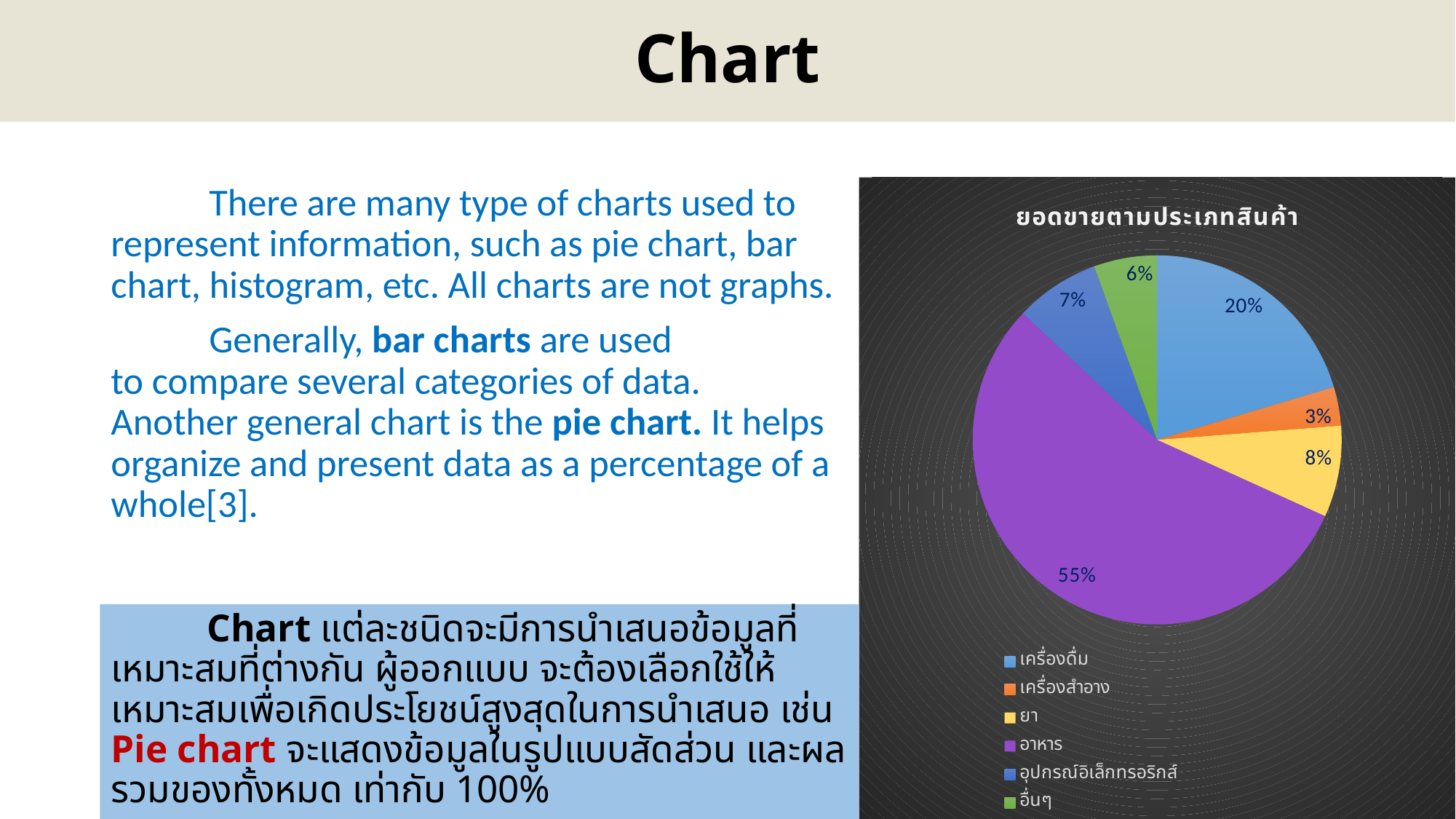
How many categories does the pie chart's legend list? 6 What share of the pie does ยา have? 8% Which category has the largest slice of the pie? อาหาร What kind of chart is shown on the slide? Pie chart What share of the pie does เครื่องสำอาง have? 3% Which has a larger share, อุปกรณ์อิเล็กทรอนิกส์ or อื่นๆ? อุปกรณ์อิเล็กทรอริกส์ Which category has the smallest slice of the pie? เครื่องสำอาง What share of the pie does อาหาร have? 55% What is the title of the pie chart? ยอดขายตามประเภทสินค้า Which colour represents อาหาร in the pie chart? Purple What is the difference between the shares of อาหาร and เครื่องดื่ม? 35%